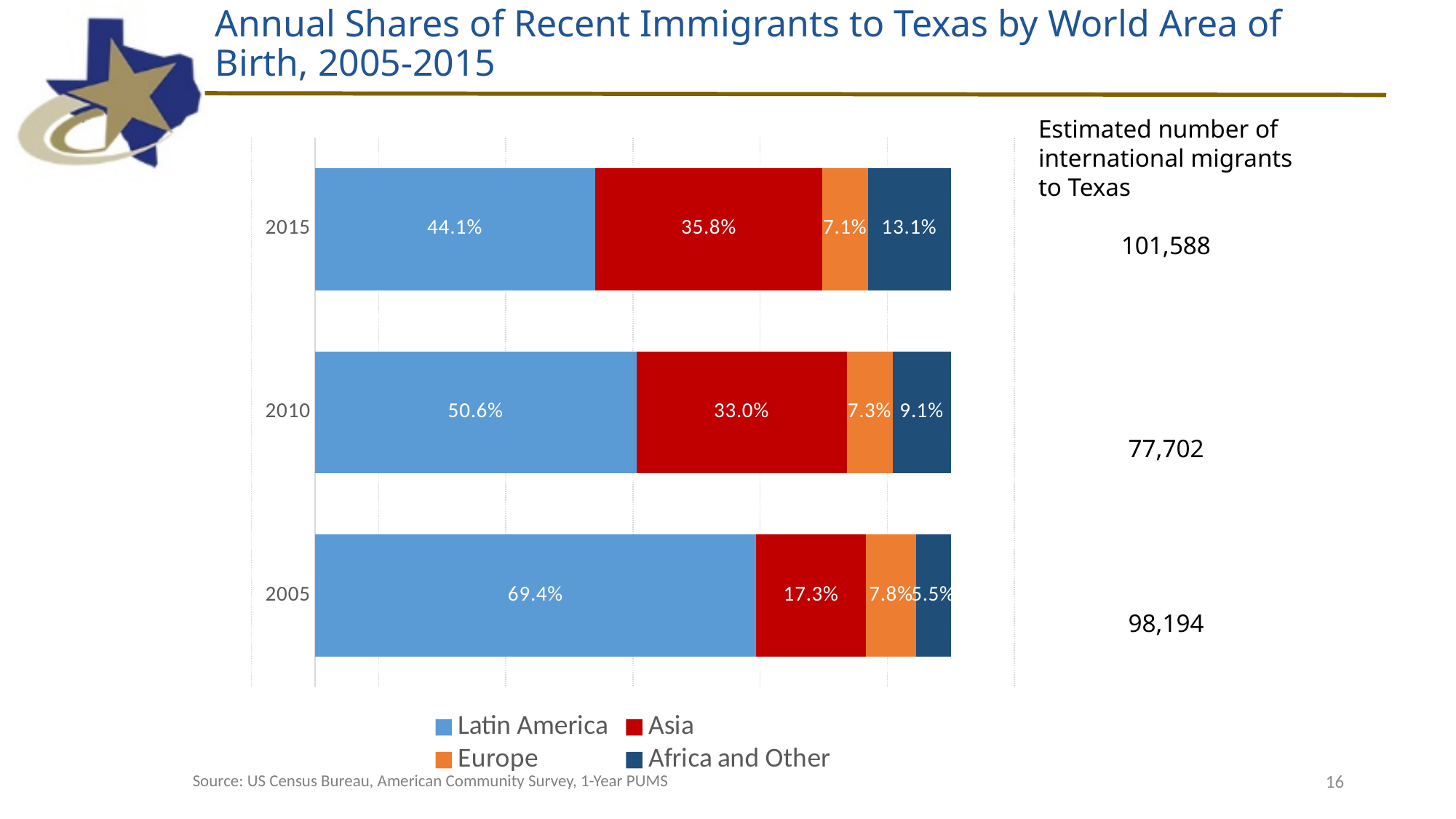
In which year was the Latin America share of recent immigrants to Texas highest? 2005 By how many percentage points did the Latin America share fall from 2005 to 2015? 25.3 percentage points How many years are shown on the chart? 3 What kind of chart is shown on the slide? Stacked bar chart What share of recent immigrants to Texas in 2015 were born in Africa and Other areas? 13.1% In which year was the Asia share of recent immigrants to Texas lowest? 2005 Which was larger in 2010: the Asia share or the Latin America share? Latin America What share of recent immigrants to Texas in 2010 were born in Europe? 7.3% What share of recent immigrants to Texas in 2005 were born in Asia? 17.3% What share of recent immigrants to Texas in 2015 were born in Latin America? 44.1% How many world areas of birth does the legend list? 4 What was the estimated number of international migrants to Texas in 2015? 101,588